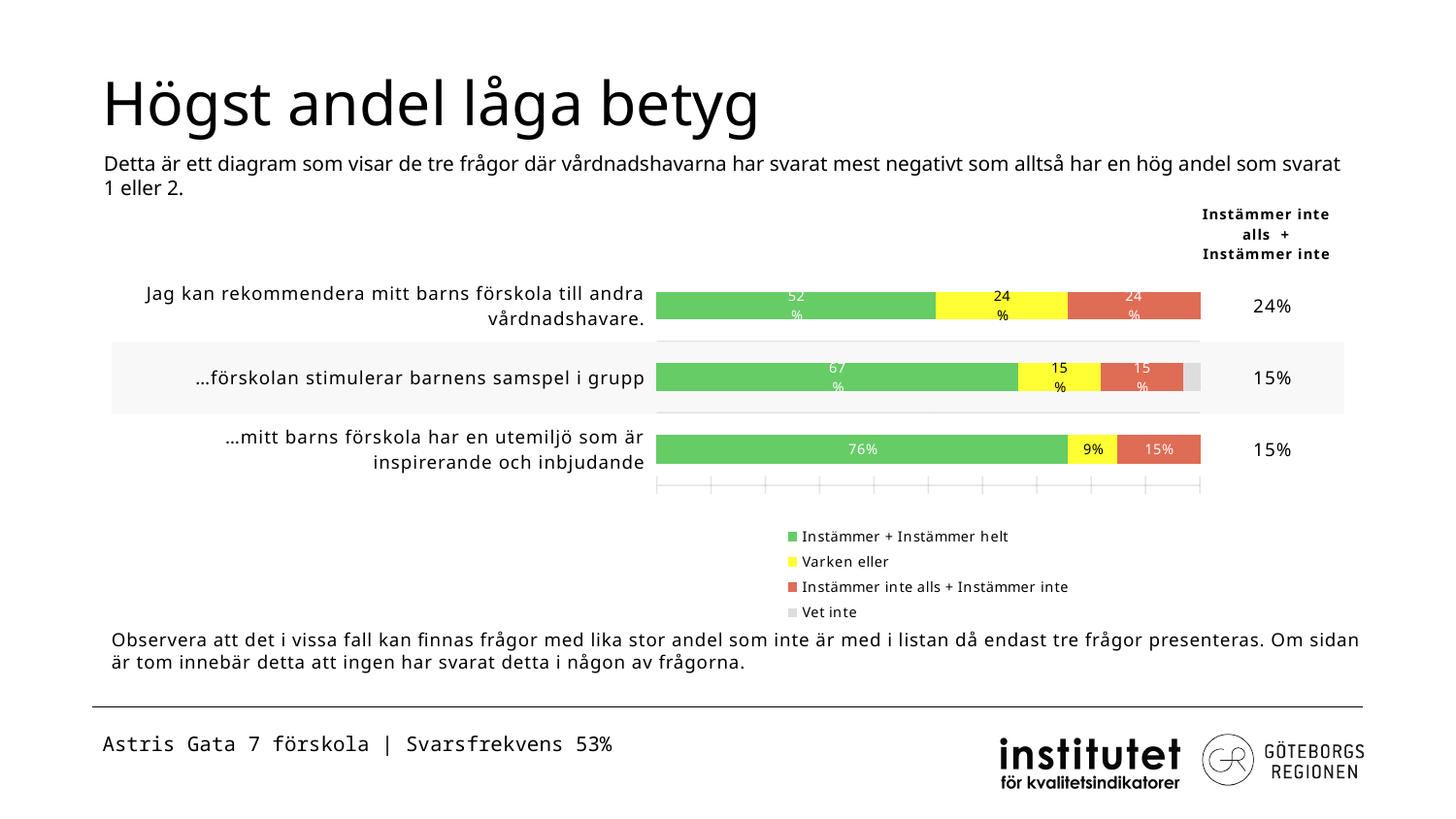
How many questions (categories) are plotted in the chart? 3 What kind of chart is shown on the slide? bar chart What value is shown in the 'Instämmer inte alls + Instämmer inte' column for 'Jag kan rekommendera mitt barns förskola till andra vårdnadshavare.'? 24% Which legend entry is shown in yellow? Varken eller Which question has the highest 'Instämmer inte alls + Instämmer inte' share? Jag kan rekommendera mitt barns förskola till andra vårdnadshavare. What is the 'Varken eller' share for '…mitt barns förskola har en utemiljö som är inspirerande och inbjudande'? 9% What is the 'Instämmer + Instämmer helt' share for '…mitt barns förskola har en utemiljö som är inspirerande och inbjudande'? 76% What is the difference between the 'Instämmer + Instämmer helt' shares for '…mitt barns förskola har en utemiljö som är inspirerande och inbjudande' and 'Jag kan rekommendera mitt barns förskola till andra vårdnadshavare.'? 24% Which question has the highest 'Instämmer + Instämmer helt' share? …mitt barns förskola har en utemiljö som är inspirerande och inbjudande What is the 'Instämmer + Instämmer helt' share for 'Jag kan rekommendera mitt barns förskola till andra vårdnadshavare.'? 52% What is the 'Varken eller' share for '…förskolan stimulerar barnens samspel i grupp'? 15% How many series does the legend list? 4